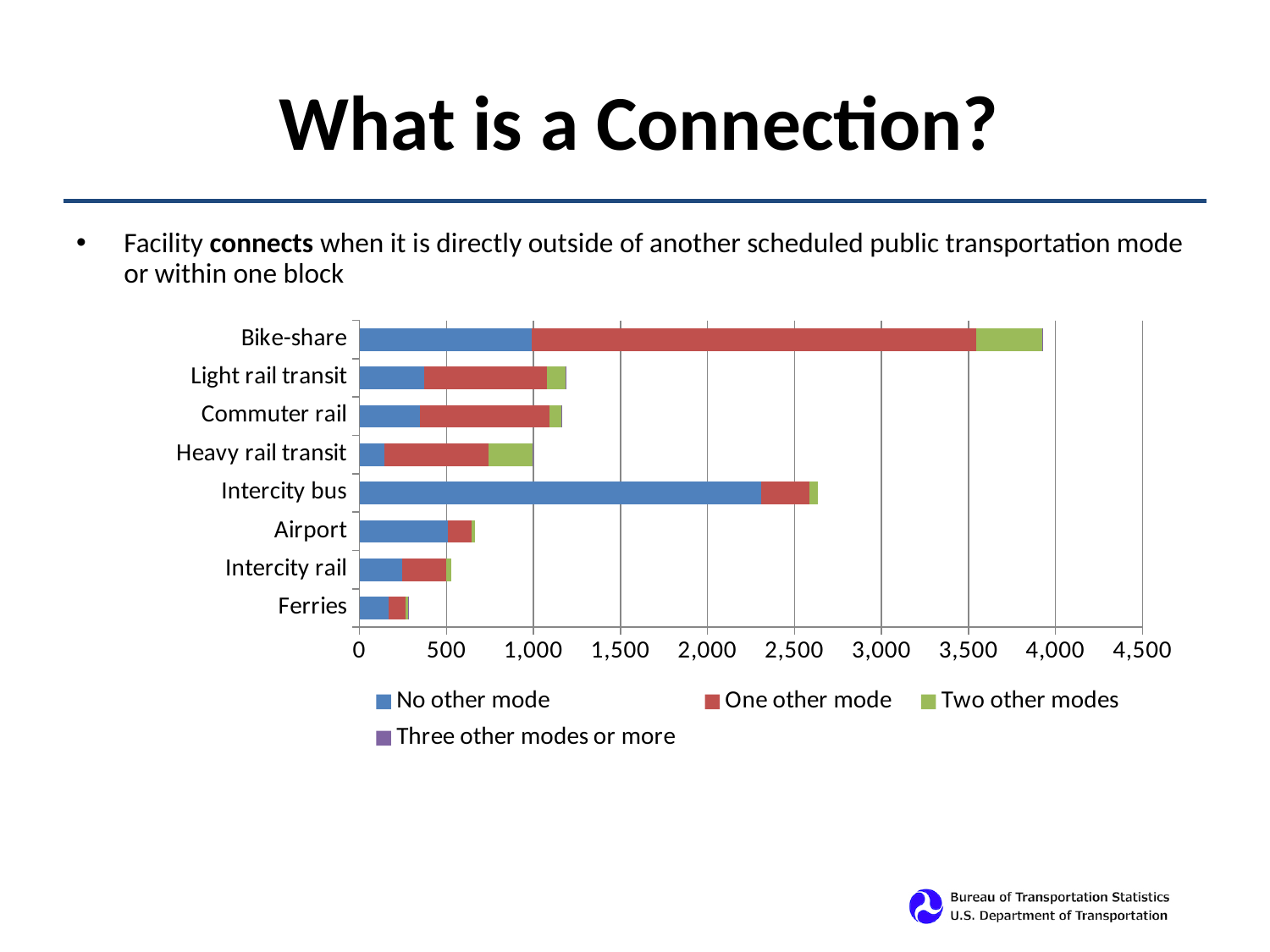
Which category has the shortest total bar in the chart? Ferries Is the total bar length for Light rail transit greater or less than 1,000? greater Is the total bar length for Bike-share greater or less than 3,500? greater How many transportation modes (categories) are listed on the vertical axis of the chart? 8 How many series does the chart's legend list? 4 Which category has the longest total bar in the chart? Bike-share What kind of chart is shown on the slide? Stacked bar chart Is the total bar length for Ferries greater or less than 500? less Which category has the largest 'No other mode' segment? Intercity bus Which series is shown in red in the chart's legend? One other mode Which has the longer total bar, Bike-share or Intercity bus? Bike-share